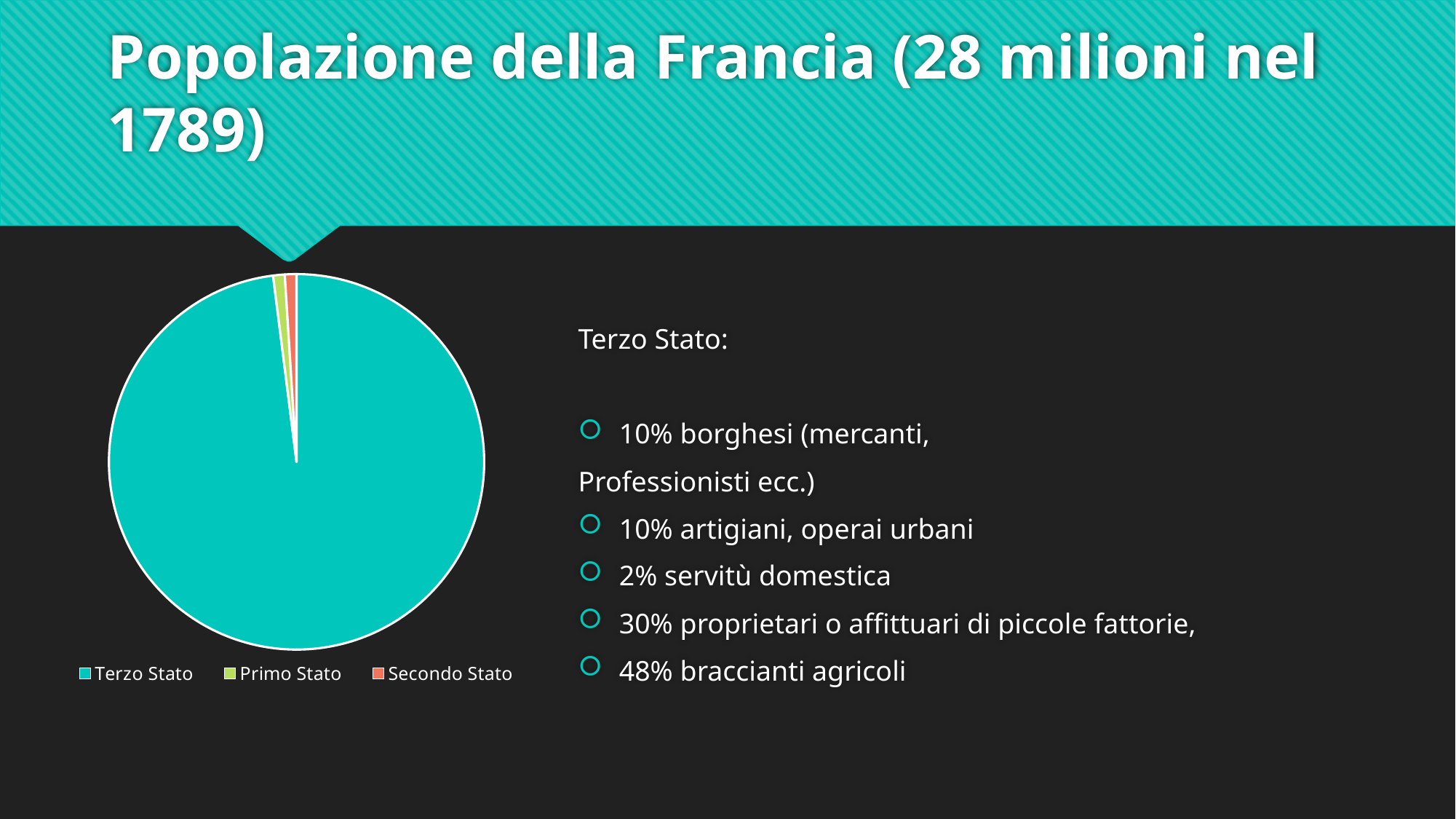
How many slices does the pie chart have? 3 Which slice is larger in the pie chart, Secondo Stato or Terzo Stato? Terzo Stato What are the three categories listed in the legend of the pie chart? Terzo Stato, Primo Stato, Secondo Stato What kind of chart is shown on the slide? Pie chart Which slice is larger in the pie chart, Terzo Stato or Primo Stato? Terzo Stato How many entries does the legend of the pie chart list? 3 Which category has the largest slice in the pie chart? Terzo Stato Where is the legend positioned relative to the pie chart? Below the chart